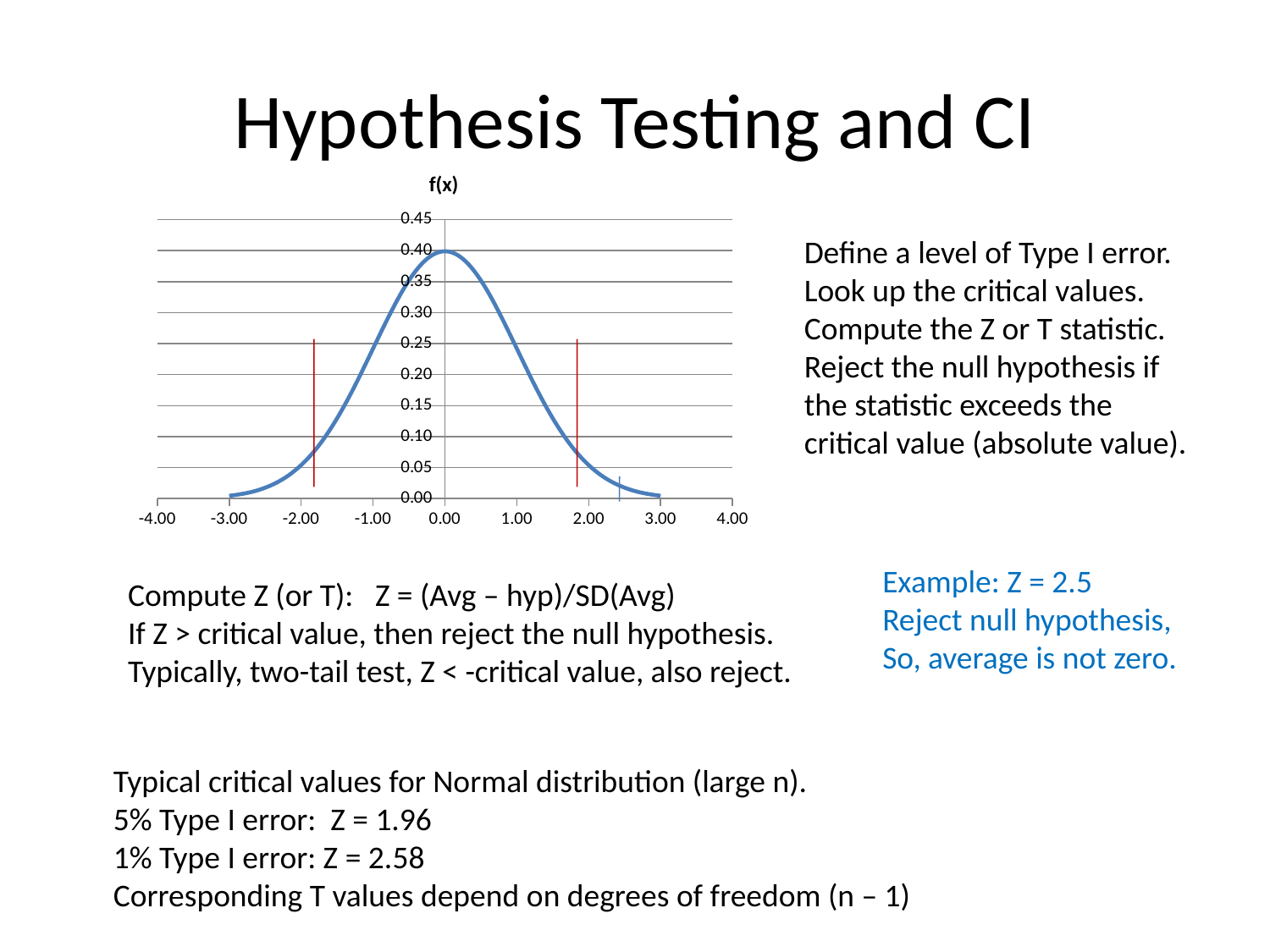
Is the value of the curve at x = 2.00 greater or less than 0.10? less What is the highest value shown on the vertical axis? 0.45 What is the title of the chart? f(x) Does the curve rise or fall as x goes from 0.00 to 3.00? fall Which is larger, the value of the curve at x = 0.00 or at x = 2.00? x = 0.00 Is the value of the curve at x = -3.00 greater or less than 0.05? less What kind of chart is shown on the slide? line chart At which x value does the curve reach its highest point? 0.00 Does the curve rise or fall as x goes from -3.00 to 0.00? rise How many red vertical lines are drawn on the chart? 2 Is the value of the curve at x = 0.00 greater or less than 0.35? greater